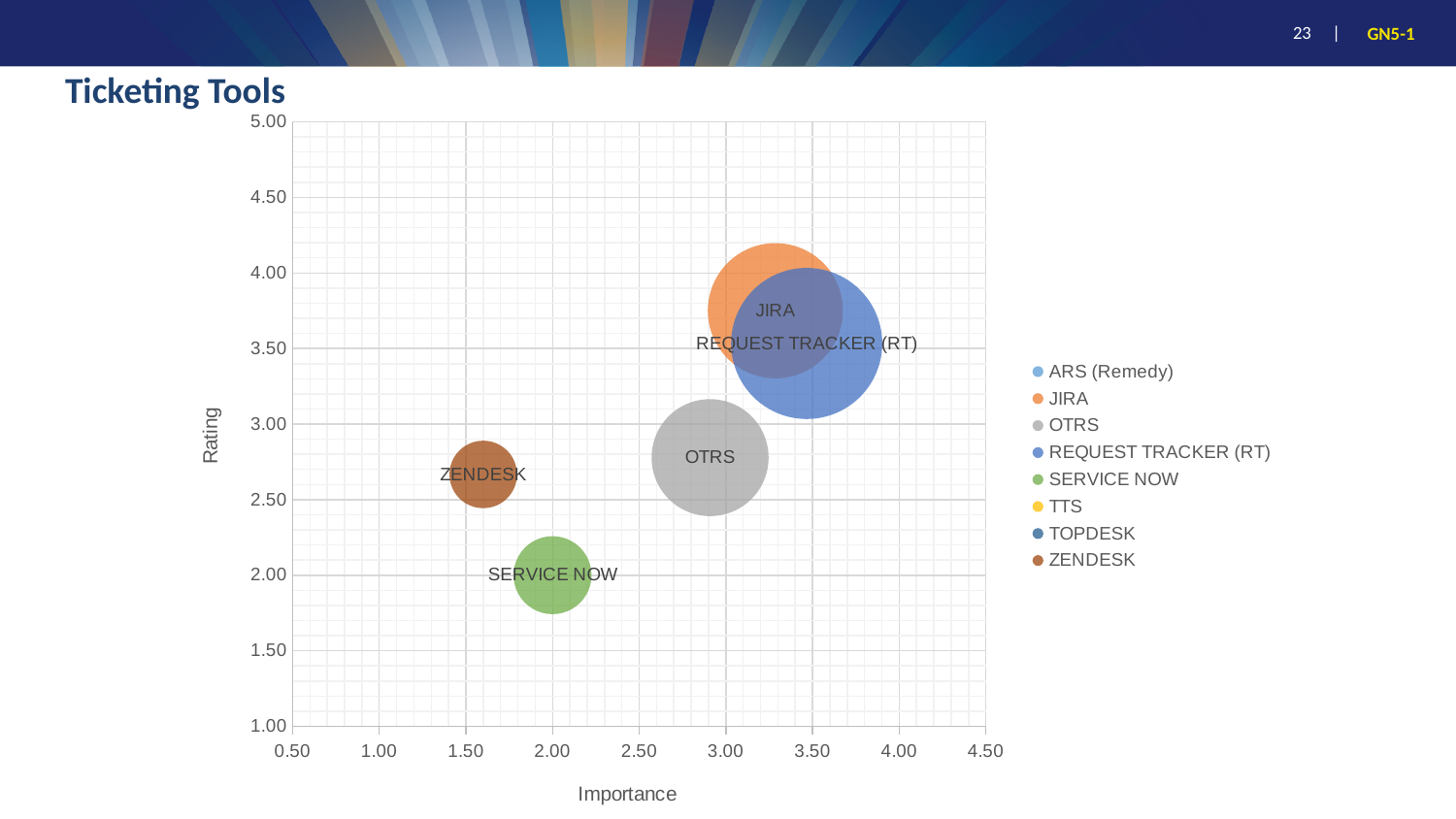
Which tool has the lowest Rating? SERVICE NOW Is the Rating for SERVICE NOW greater or less than 2.50? less How many bubbles are plotted on the chart? 5 Is the Importance for ZENDESK greater or less than 2.00? less What is the label of the horizontal axis? Importance Is the Importance for OTRS greater or less than 2.50? greater Which tool has the lowest Importance? ZENDESK How many series does the legend list? 8 Which tool has the highest Rating? JIRA Which has the higher Rating, OTRS or SERVICE NOW? OTRS What kind of chart is shown on the slide? bubble chart